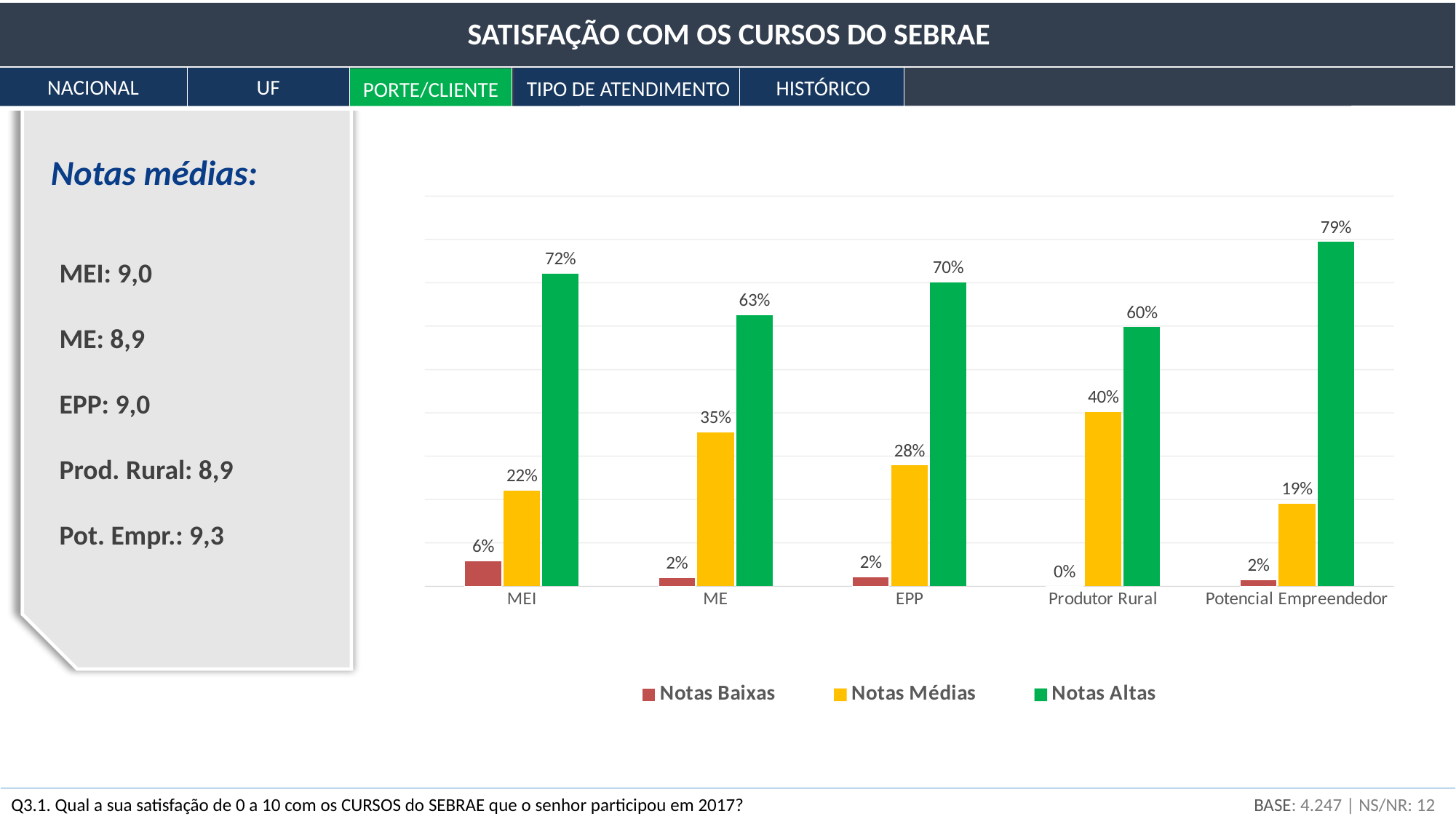
What is the Notas Médias value for Produtor Rural? 40% How many series does the legend list? 3 Which colour represents the Notas Altas series in the legend? Green What is the Notas Altas value for MEI? 72% What is the difference between the Notas Altas values for Potencial Empreendedor and ME? 16% Which is larger, the Notas Médias value for ME or for EPP? ME Which category has the highest Notas Altas value? Potencial Empreendedor What is the Notas Baixas value for Potencial Empreendedor? 2% What kind of chart is shown on the slide? Bar chart How many categories are shown on the x axis? 5 Which category has the lowest Notas Altas value? Produtor Rural What is the total of the three series for EPP? 100%